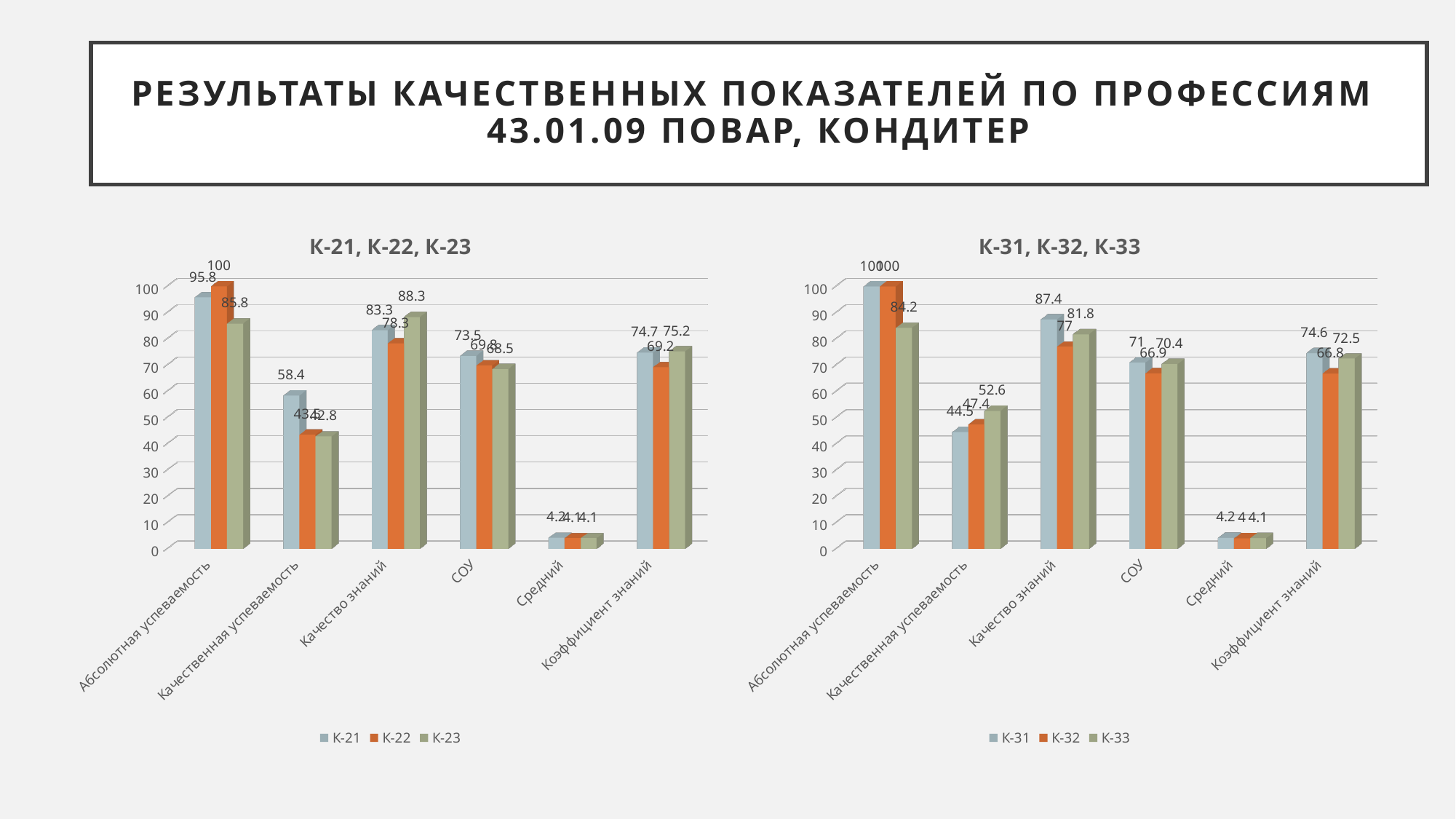
In the chart titled К-21, К-22, К-23, which series has the highest value in Качество знаний? К-23 In the chart titled К-21, К-22, К-23, how many series does the legend list? 3 In the chart titled К-31, К-32, К-33, what is the value for К-32 in Качество знаний? 77 In the chart titled К-31, К-32, К-33, which series has the lowest value in Качественная успеваемость? К-31 What kind of chart is the chart titled К-31, К-32, К-33? Bar chart In the chart titled К-31, К-32, К-33, which is larger in Коэффициент знаний: К-31 or К-32? К-31 In the chart titled К-21, К-22, К-23, what is the difference between К-21 and К-22 in СОУ? 3.7 In the chart titled К-31, К-32, К-33, how many categories are shown on the x axis? 6 In the chart titled К-21, К-22, К-23, what is the value for К-21 in Качественная успеваемость? 58.4 In the chart titled К-21, К-22, К-23, what is the value for К-22 in Абсолютная успеваемость? 100 In the chart titled К-31, К-32, К-33, what is the value for К-33 in Абсолютная успеваемость? 84.2 In the chart titled К-21, К-22, К-23, what is the value for К-23 in Качество знаний? 88.3